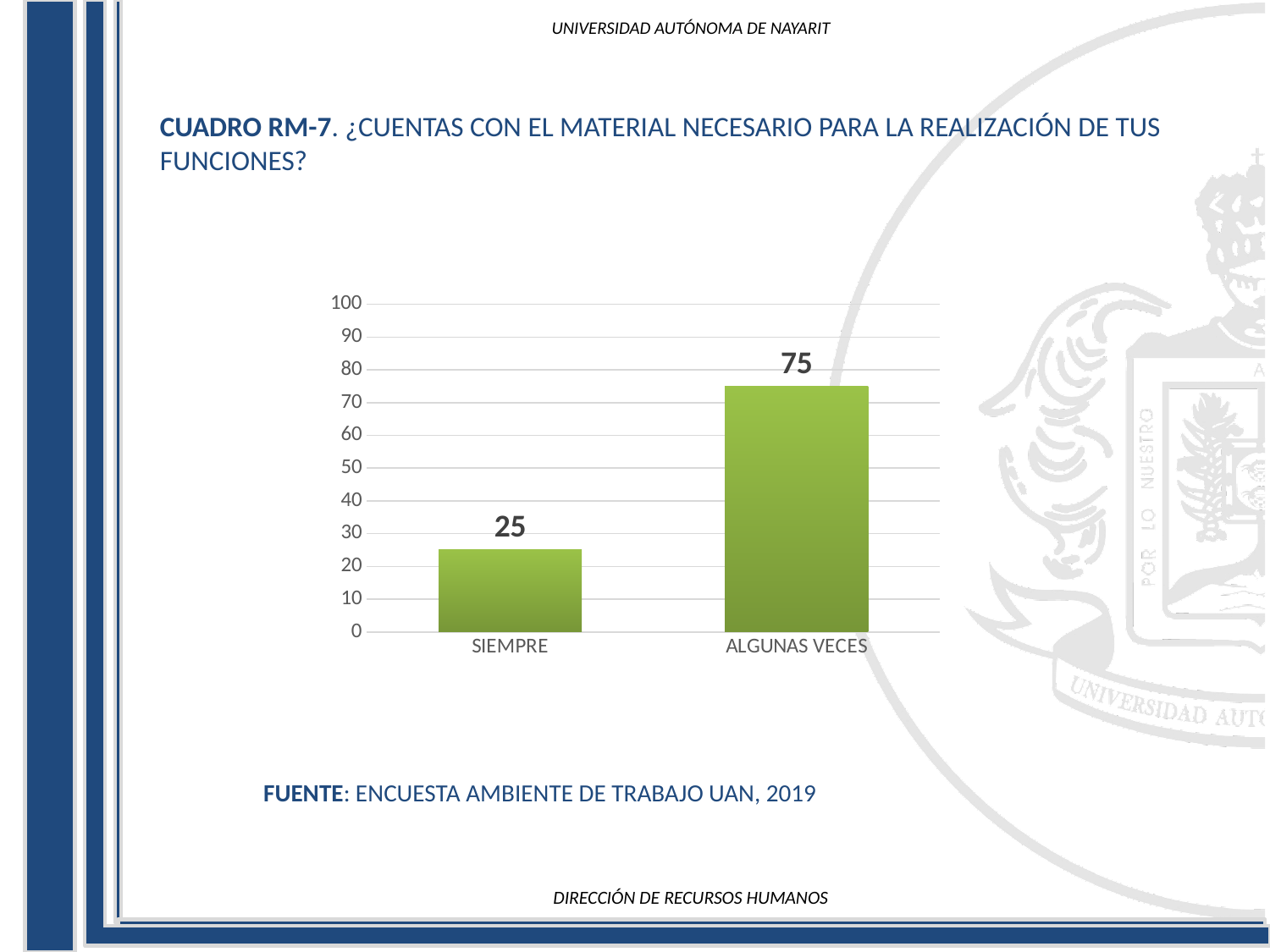
Is the value for SIEMPRE greater or less than 40? less What is the value for ALGUNAS VECES? 75 Is the value for ALGUNAS VECES greater or less than 50? greater What is the total of the two bar values? 100 How many categories are shown on the x axis? 2 What kind of chart is shown on the slide? bar chart What is the maximum value shown on the y axis? 100 Which is larger, the value for SIEMPRE or the value for ALGUNAS VECES? ALGUNAS VECES Which category has the lowest value? SIEMPRE What is the difference between the values for ALGUNAS VECES and SIEMPRE? 50 Which category has the highest value? ALGUNAS VECES What is the value for SIEMPRE? 25